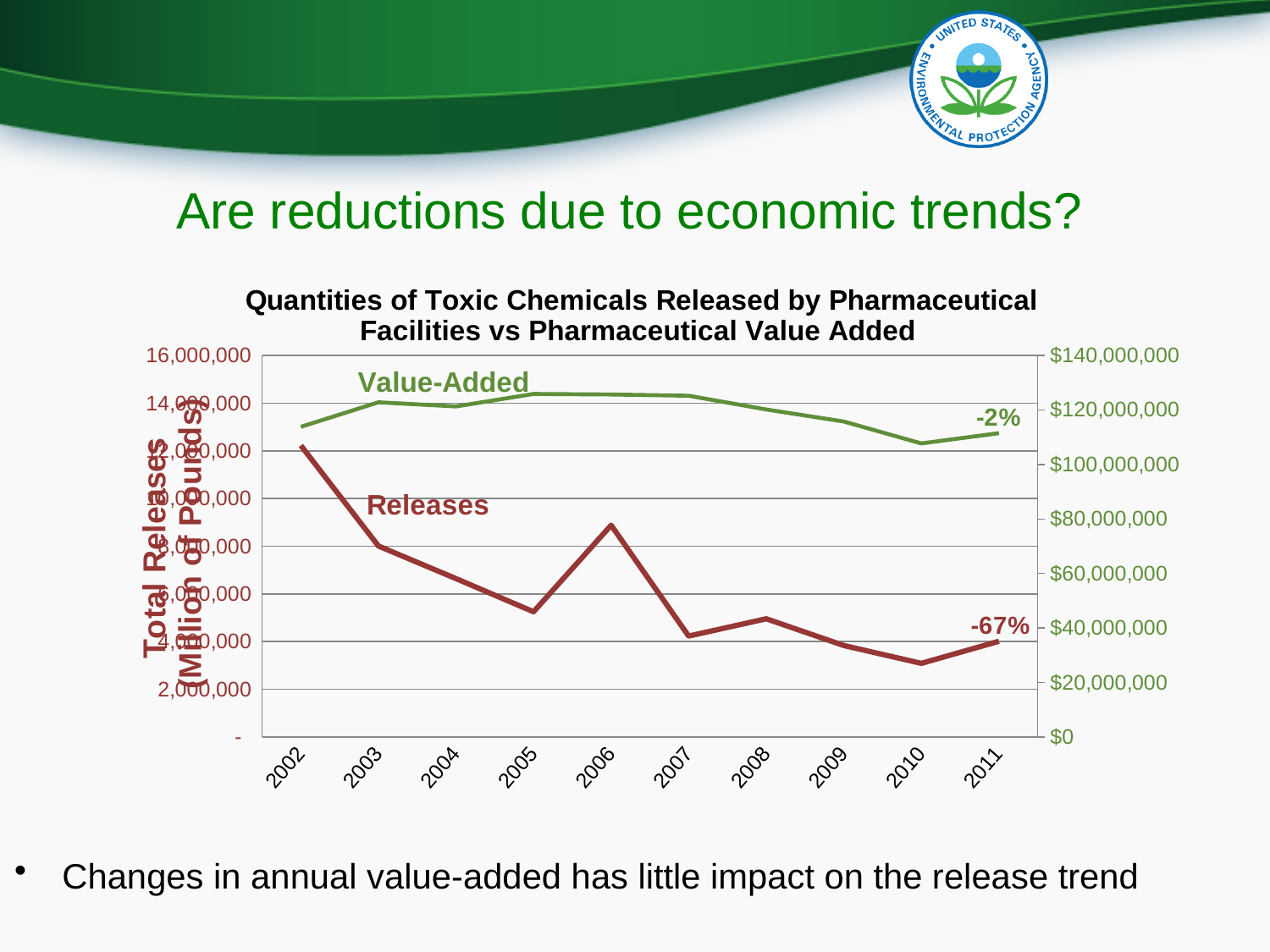
In which year is the Releases line at its highest? 2002 Which year has the larger Releases value, 2006 or 2007? 2006 How many data series are plotted on the chart? 2 What percentage change is annotated for the Releases line at 2011? -67% Is the Releases value for 2002 greater or less than 10,000,000? greater Is the Releases value for 2010 greater or less than 4,000,000? less Is the Value-Added value for 2002 greater or less than $100,000,000? greater How many years are plotted along the x axis of the chart? 10 What kind of chart is shown on the slide? Line chart In which year is the Releases line at its lowest? 2010 Overall, does the Releases line rise or fall from 2002 to 2011? Fall What percentage change is annotated for the Value-Added line at 2011? -2%